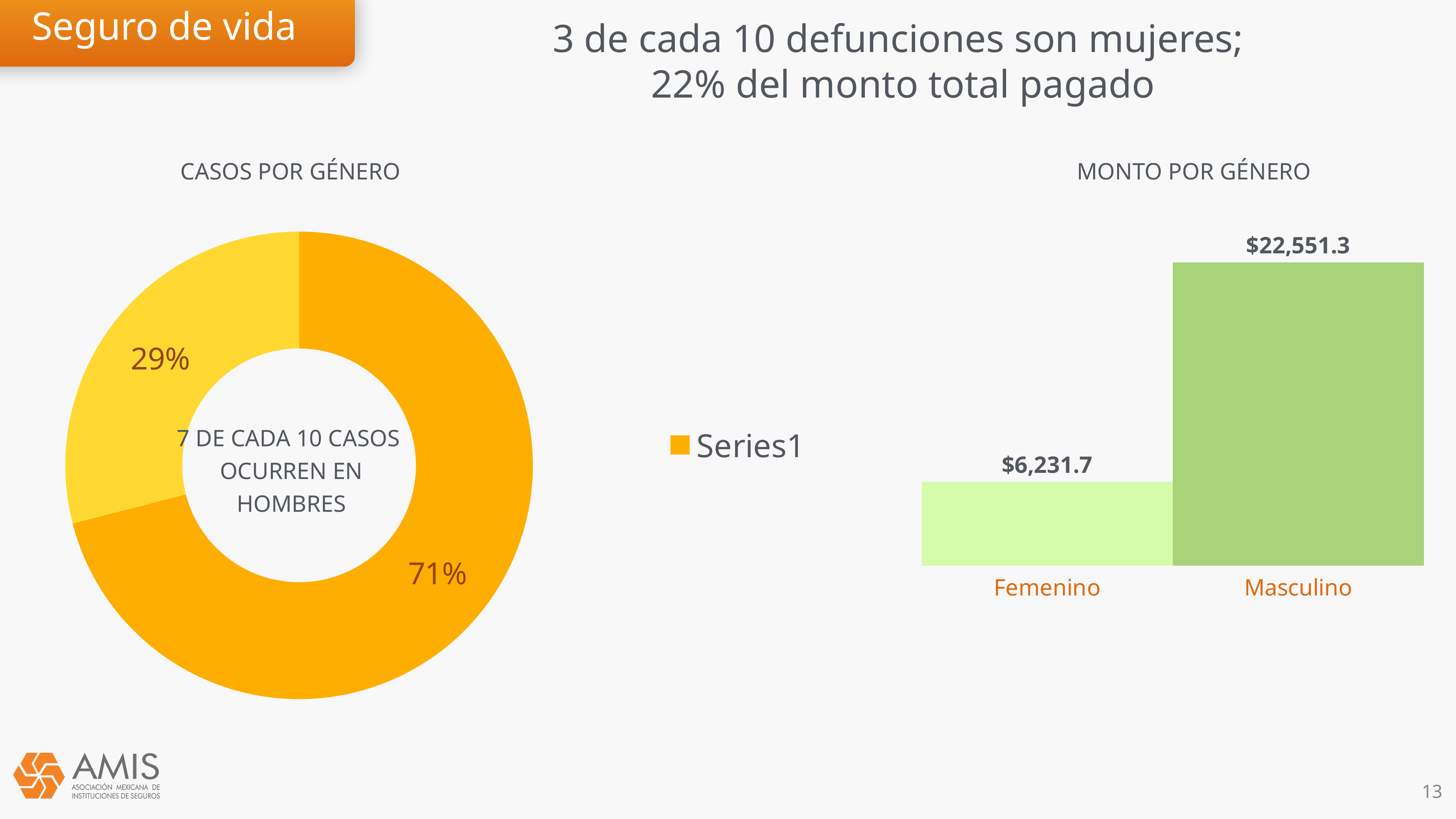
What kind of chart is the CASOS POR GÉNERO chart? donut chart What text appears in the centre of the CASOS POR GÉNERO donut chart? 7 DE CADA 10 CASOS OCURREN EN HOMBRES In the MONTO POR GÉNERO chart, what is the value for Masculino? $22,551.3 What kind of chart is the MONTO POR GÉNERO chart? bar chart In the MONTO POR GÉNERO chart, which category has the lowest value? Femenino In the MONTO POR GÉNERO chart, which category has the highest value? Masculino In the MONTO POR GÉNERO chart, is the value for Femenino larger or smaller than the value for Masculino? smaller In the CASOS POR GÉNERO chart, what share does the smaller slice represent? 29% In the CASOS POR GÉNERO chart, what share does the larger slice represent? 71% In the MONTO POR GÉNERO chart, what is the value for Femenino? $6,231.7 How many categories are shown in the MONTO POR GÉNERO chart? 2 In the MONTO POR GÉNERO chart, what is the difference between the Masculino and Femenino values? $16,319.6